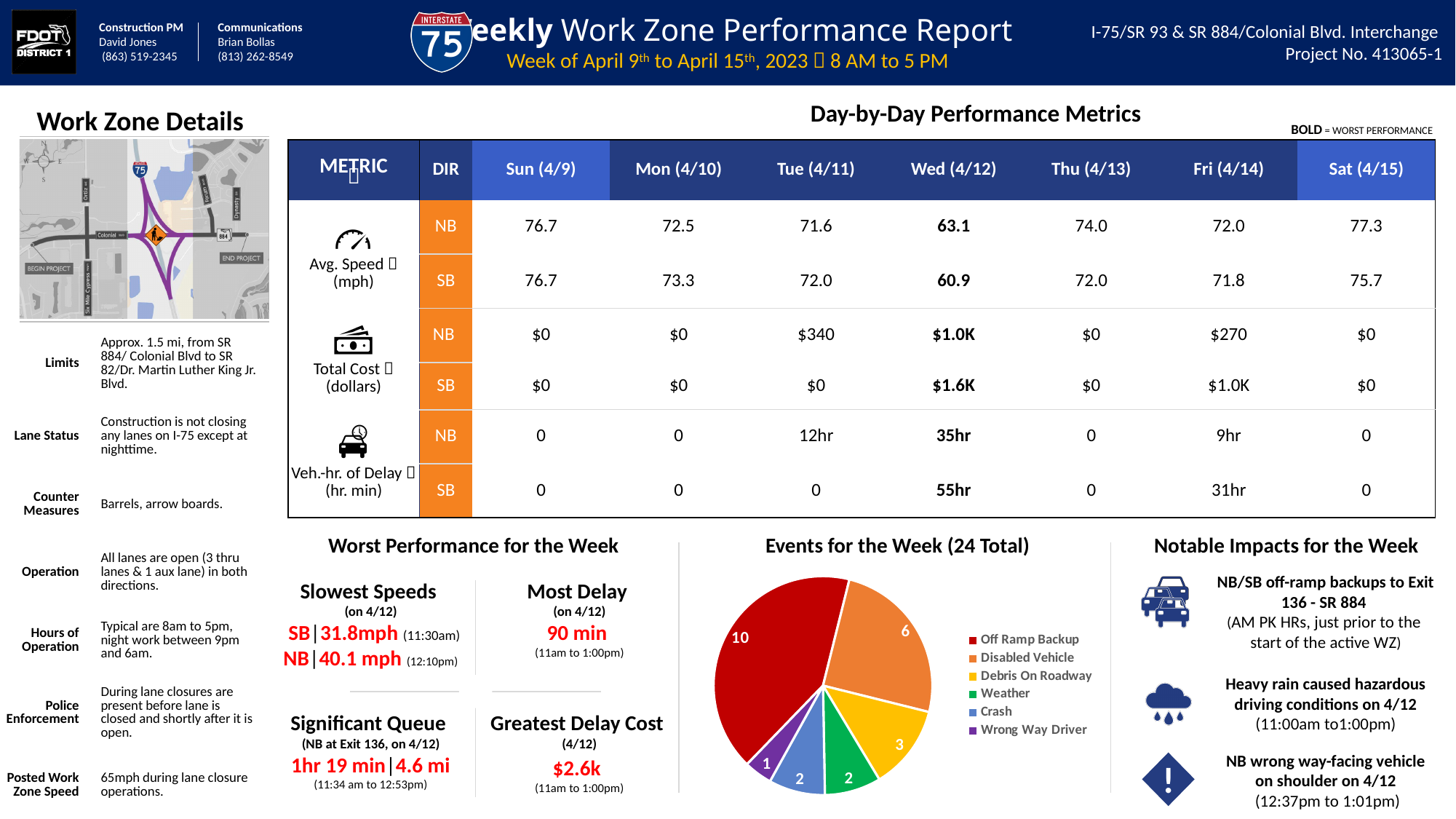
In the 'Events for the Week' pie chart, how many events were Disabled Vehicles? 6 How many event categories does the legend of the 'Events for the Week' pie chart list? 6 In the 'Events for the Week' pie chart, how many events were Wrong Way Driver? 1 In the 'Events for the Week' pie chart, how many more Off Ramp Backup events were there than Disabled Vehicle events? 4 In the 'Events for the Week' pie chart, how many events were Off Ramp Backups? 10 In the 'Events for the Week' pie chart, how many events were Debris On Roadway? 3 In the 'Events for the Week' pie chart, which event type has the smallest slice? Wrong Way Driver In the 'Events for the Week' pie chart, what share of the 24 total events were Debris On Roadway? 12.5% In the 'Events for the Week' pie chart, which is larger: Disabled Vehicle or Debris On Roadway? Disabled Vehicle What kind of chart is the 'Events for the Week (24 Total)' chart? pie chart In the 'Events for the Week' pie chart, which event type has the largest slice? Off Ramp Backup In the 'Events for the Week' pie chart, what colour is the Weather slice? green